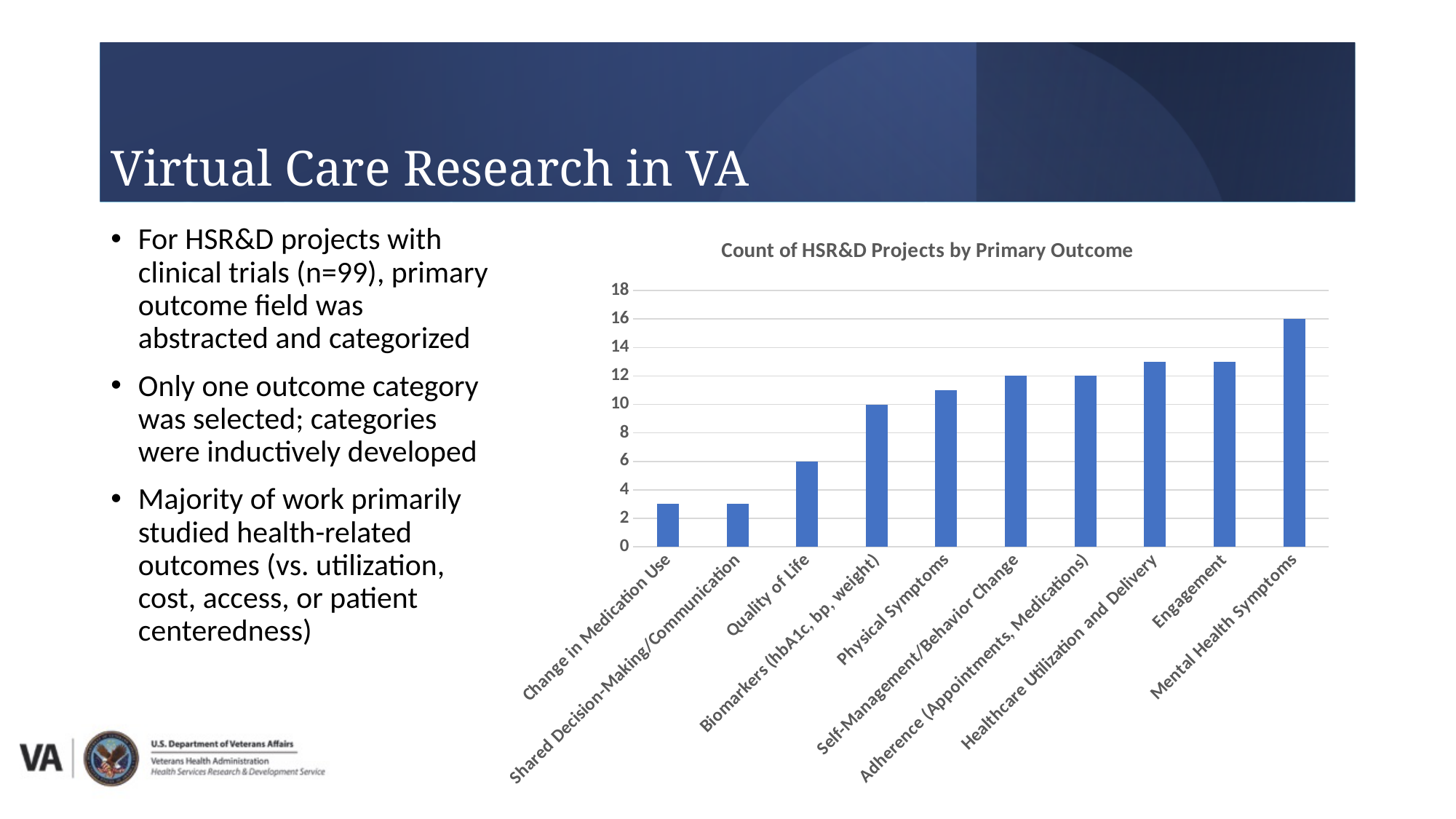
Which has a higher count, Mental Health Symptoms or Self-Management/Behavior Change? Mental Health Symptoms How many primary outcome categories are shown in the chart? 10 What is the difference between the counts for Mental Health Symptoms and Quality of Life? 10 What kind of chart is shown on the slide? bar chart What is the title of the chart? Count of HSR&D Projects by Primary Outcome Is the value for Engagement greater or less than 12? greater What is the count of projects for Quality of Life? 6 What is the count of projects for Mental Health Symptoms? 16 What is the count of projects for Biomarkers (hbA1c, bp, weight)? 10 Is the value for Change in Medication Use greater or less than 4? less Which primary outcome category has the highest count of projects? Mental Health Symptoms Do the bar values generally rise or fall from left to right along the x axis? rise